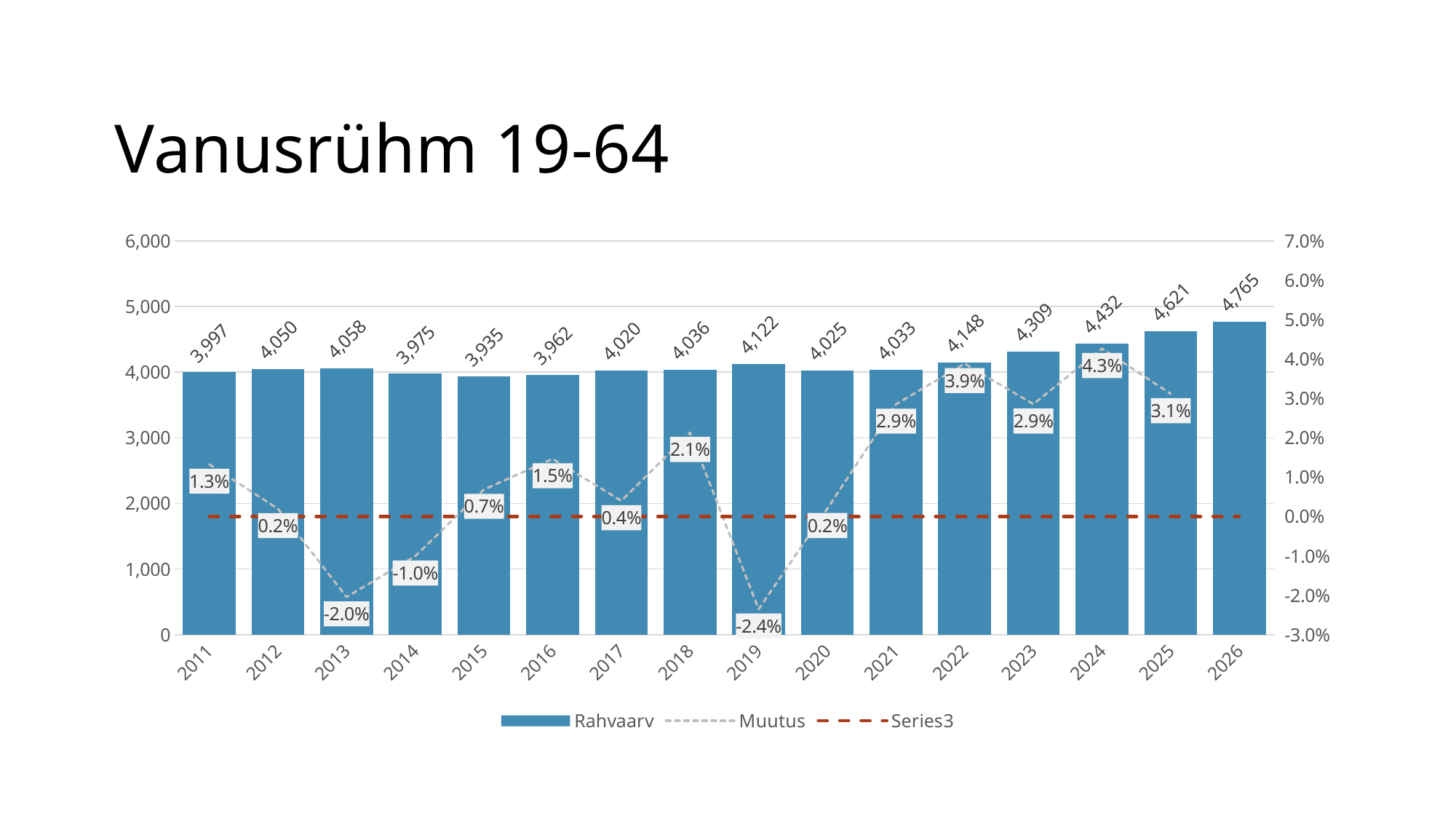
What kind of chart is used for the Rahvaarv series? bar chart Which year has a larger Rahvaarv value, 2019 or 2022? 2022 What is the difference between the Rahvaarv values for 2025 and 2024? 189 What is the difference between the Rahvaarv values for 2026 and 2011? 768 Which year has the highest Rahvaarv bar? 2026 What is the Rahvaarv value for 2026? 4,765 What is the Rahvaarv value for 2015? 3,935 Which year has the lowest Rahvaarv bar? 2015 Do the Rahvaarv values rise or fall from 2021 to 2026? rise How many series does the legend list? 3 Is the Rahvaarv value for 2014 greater or less than 4,000? less How many years are shown on the x axis? 16